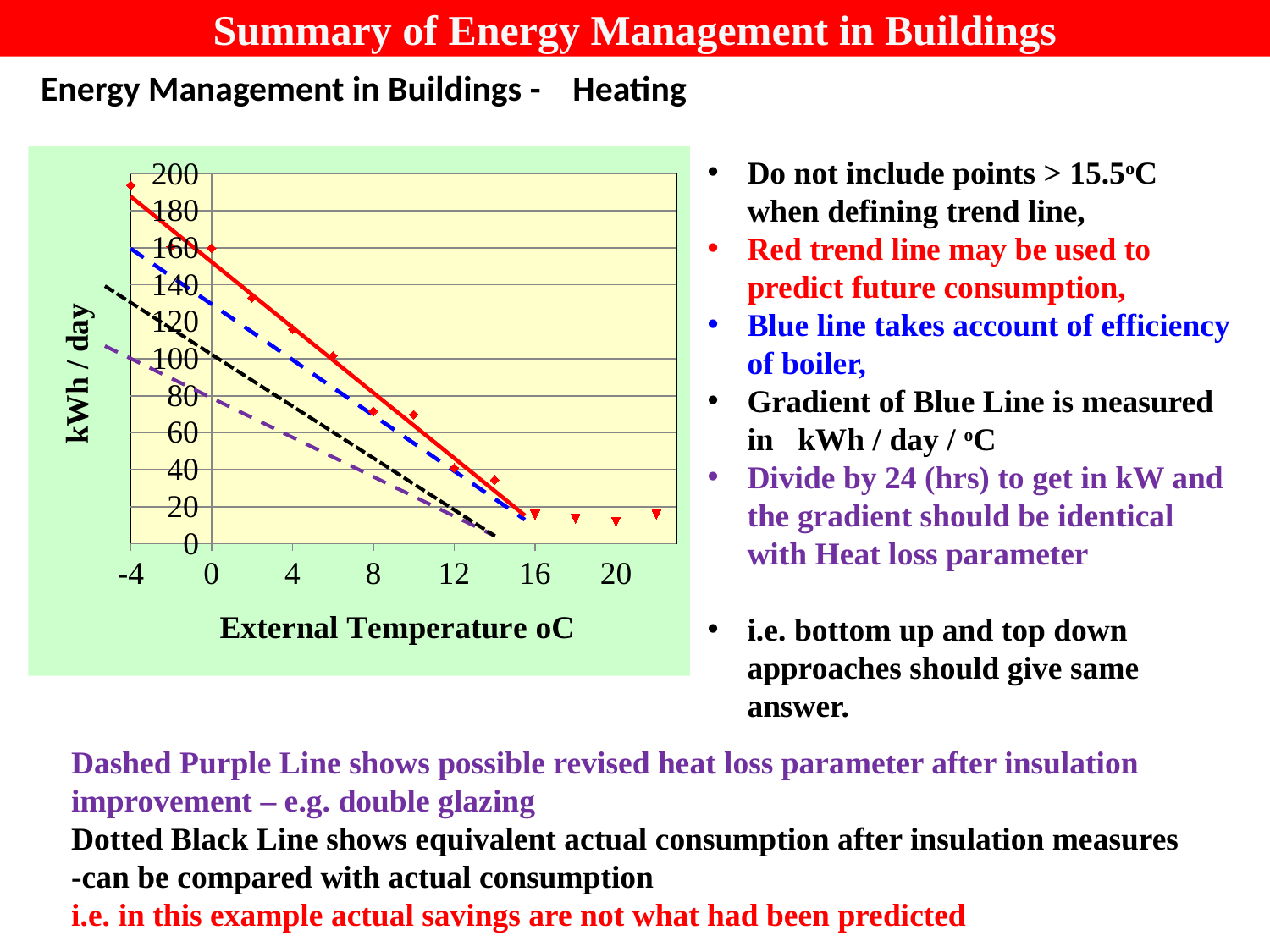
What is the title of the vertical axis of the chart? kWh / day Is the plotted value at an external temperature of 4 greater or less than 100? greater What is the title of the horizontal axis of the chart? External Temperature oC What is the maximum value shown on the vertical axis of the chart? 200 Do the plotted consumption values rise or fall as external temperature increases along the x axis? fall Which has the larger plotted consumption: external temperature 0 or external temperature 8? 0 What kind of chart is shown on the slide? scatter chart Is the plotted value at an external temperature of 12 greater or less than 60? less At which external temperature is the plotted consumption highest? -4